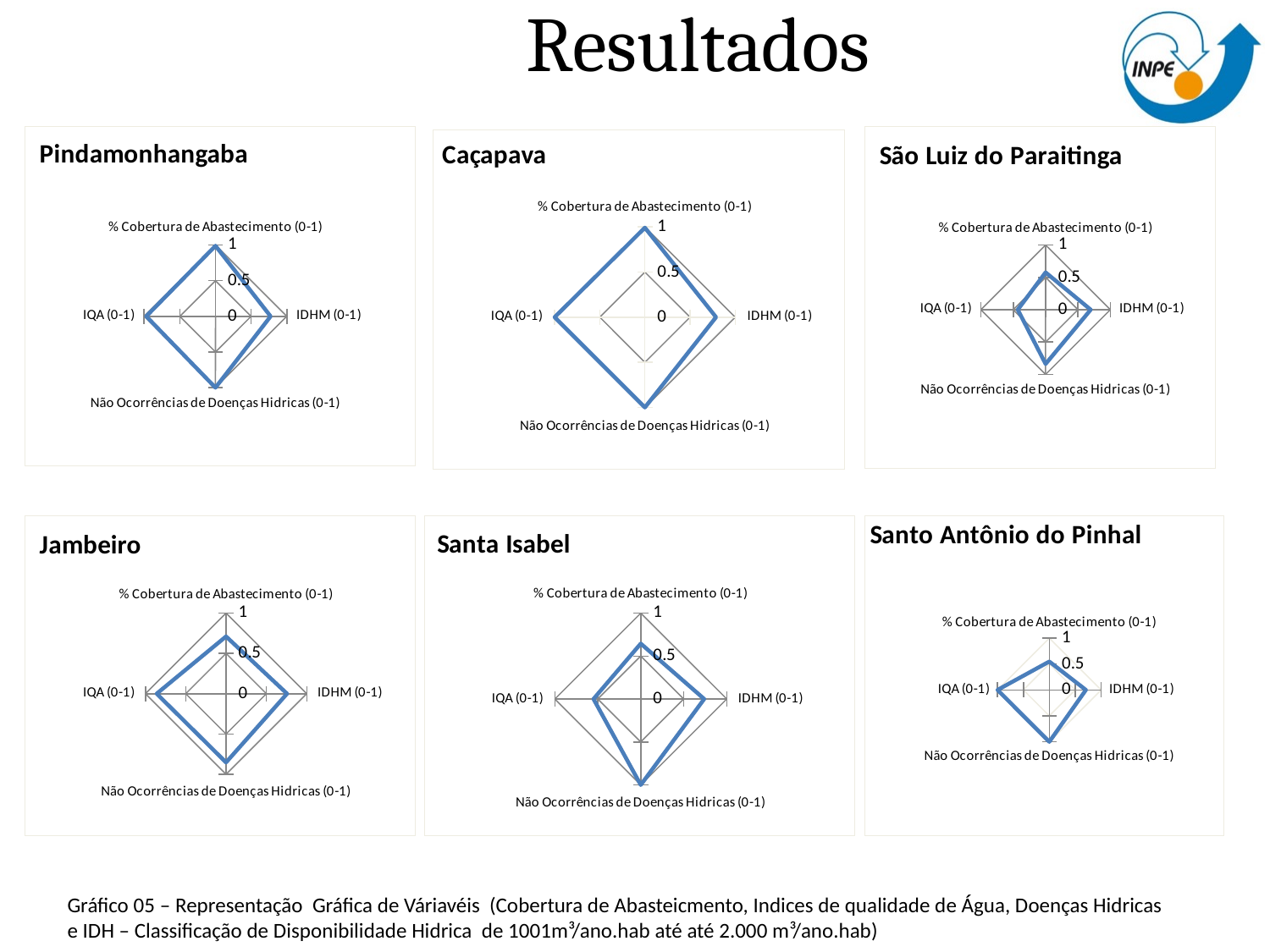
In the Santa Isabel chart, is the value for Não Ocorrências de Doenças Hidricas (0-1) greater or less than 0.5? greater In the Pindamonhangaba chart, is the value for IQA (0-1) greater or less than 0.5? greater What is the title of the top-left radar chart? Pindamonhangaba In the Caçapava chart, which is larger: IQA (0-1) or IDHM (0-1)? IQA (0-1) In the São Luiz do Paraitinga chart, which is larger: Não Ocorrências de Doenças Hidricas (0-1) or IQA (0-1)? Não Ocorrências de Doenças Hidricas (0-1) In the Caçapava chart, is the value for IDHM (0-1) greater or less than 0.5? greater What is the maximum value shown on the axis scale of the radar charts? 1 How many axes (variables) does the Caçapava radar chart have? 4 How many radar charts are shown on the slide? 6 What kind of chart is used for Pindamonhangaba? Radar chart